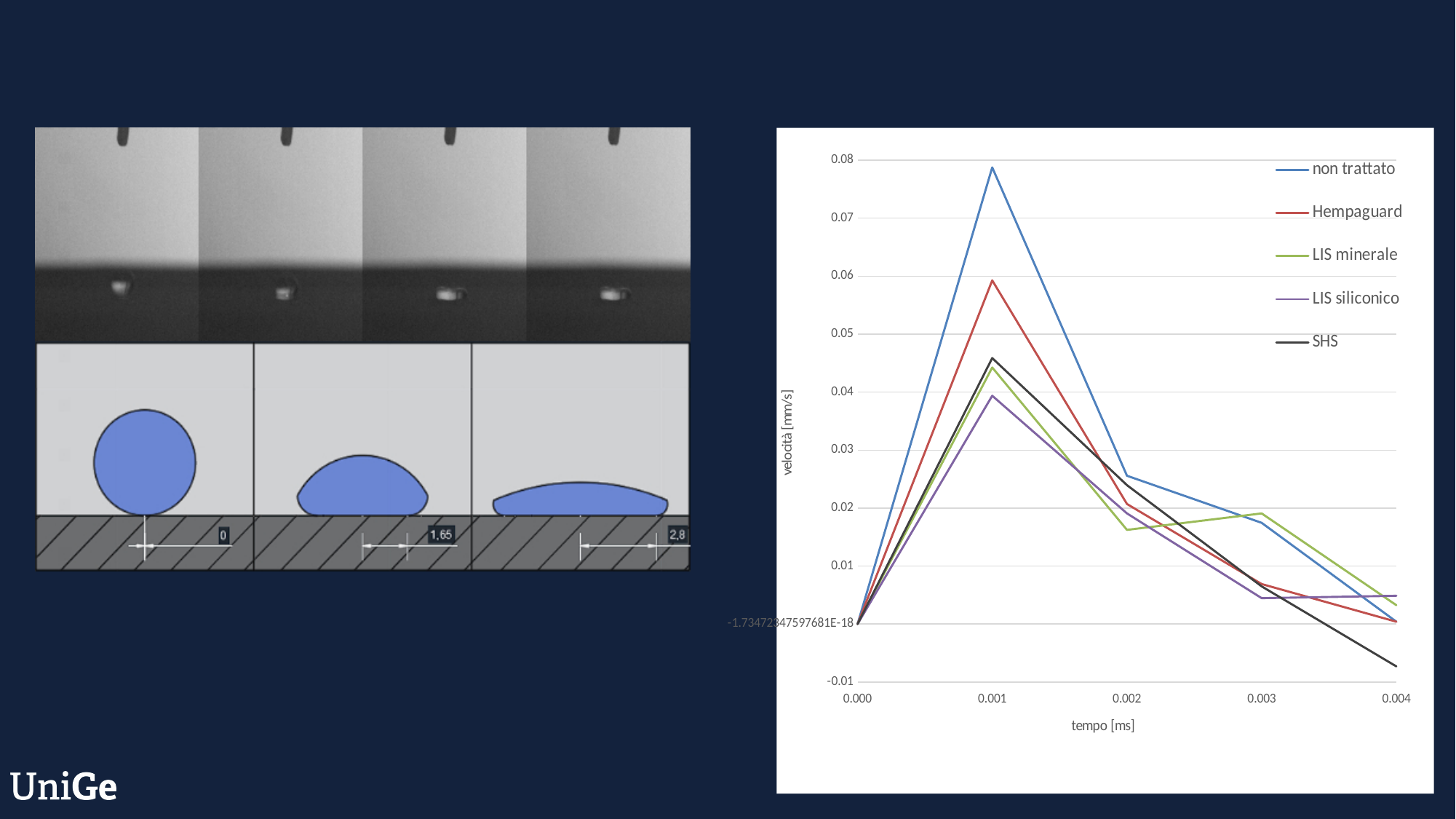
Which series has the highest value at tempo 0.001 ms? non trattato Is the value for SHS at 0.004 ms greater or less than 0? less How many time points are marked on the x axis of the chart? 5 Does the non trattato series rise or fall between 0.001 ms and 0.004 ms? fall Which series has the lowest value at tempo 0.001 ms? LIS siliconico What kind of chart is shown on the right side of the slide? line chart What is the label of the x axis of the chart? tempo [ms] At 0.004 ms, which is larger: the value for LIS minerale or the value for SHS? LIS minerale Is the value for Hempaguard at 0.001 ms greater or less than 0.05? greater Which series has the lowest value at tempo 0.004 ms? SHS Is the value for non trattato at 0.001 ms greater or less than 0.07? greater How many series does the legend of the chart list? 5